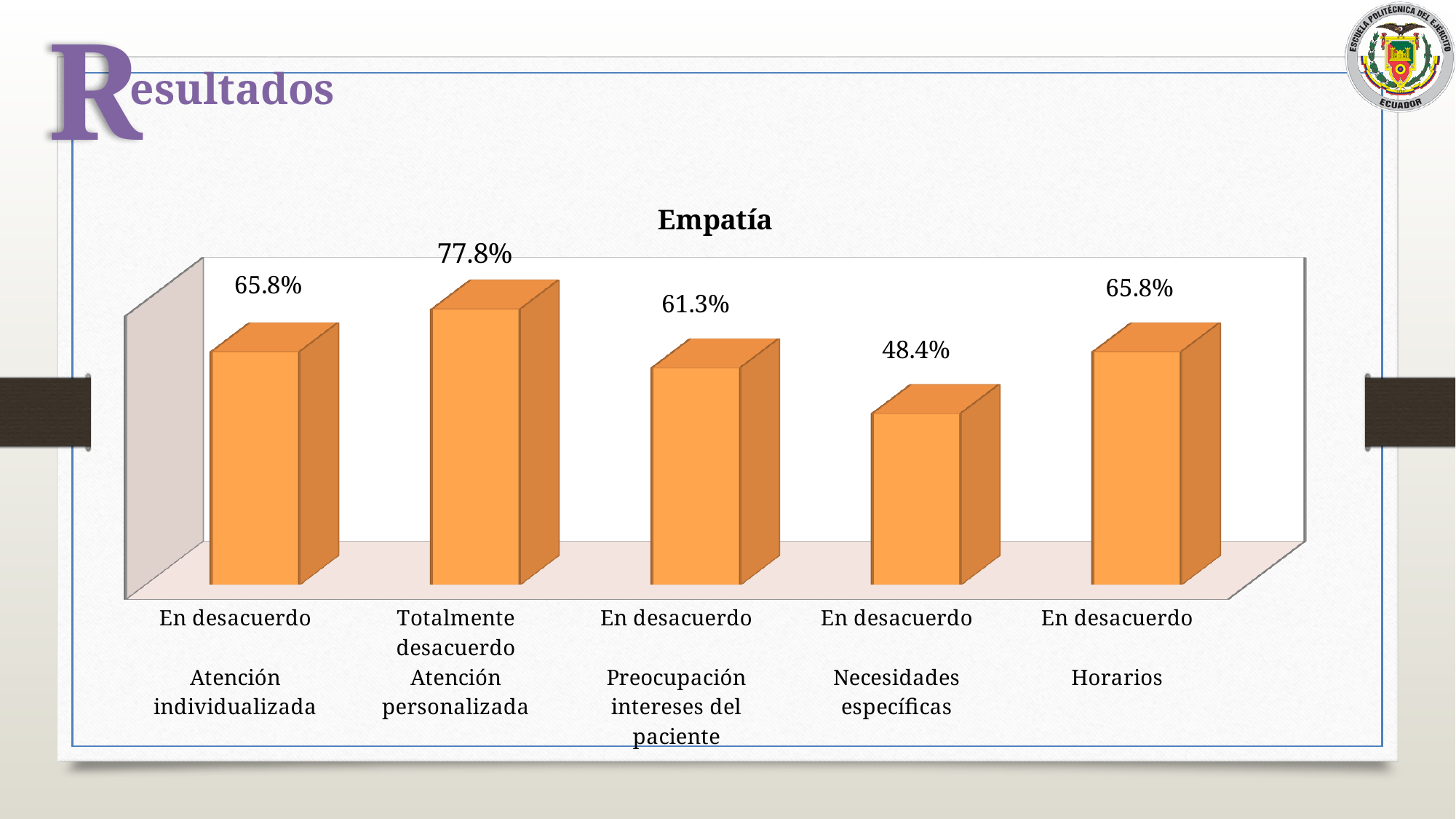
What is the value for Horarios? 65.8% What is the difference between the values for Atención personalizada and Necesidades específicas? 29.4% Which category has the lowest value? Necesidades específicas What is the value for Necesidades específicas? 48.4% Which category has the highest value? Atención personalizada Which response label is shown for Atención personalizada? Totalmente desacuerdo What kind of chart is shown on the slide? Bar chart What is the title of the chart? Empatía What is the value for Atención personalizada? 77.8% What is the value for Preocupación intereses del paciente? 61.3% Which is larger, the value for Atención individualizada or the value for Preocupación intereses del paciente? Atención individualizada How many categories are shown in the chart? 5